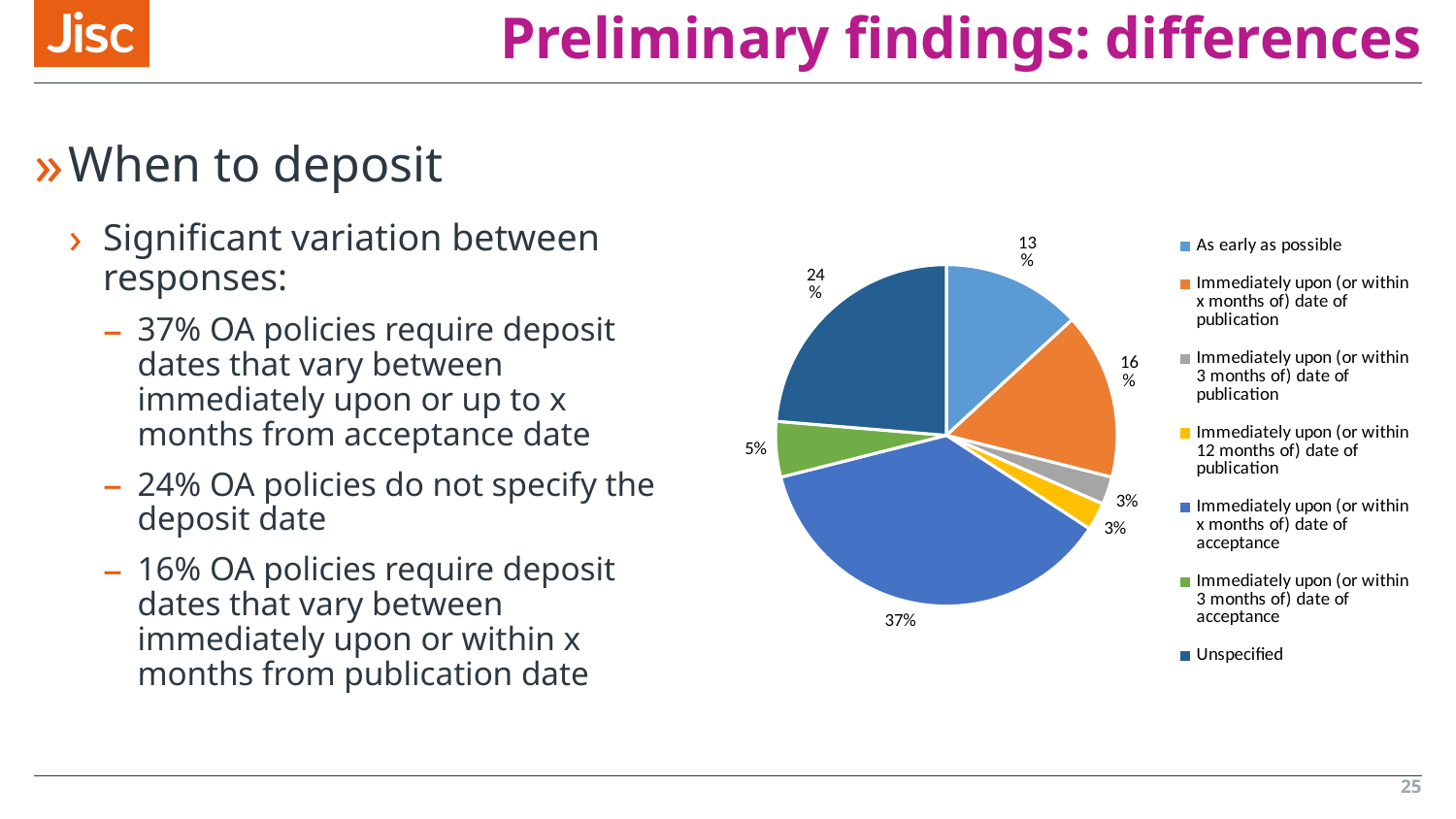
What percentage of the pie is labelled 'As early as possible'? 13% What is the difference in percentage points between the 'Immediately upon (or within x months of) date of acceptance' slice and the 'Unspecified' slice? 13 Which legend entry is shown in green? Immediately upon (or within 3 months of) date of acceptance What percentage of the pie is for 'Immediately upon (or within 3 months of) date of acceptance'? 5% Which category has the largest share of the pie? Immediately upon (or within x months of) date of acceptance Which is larger: the share for 'Unspecified' or the share for 'As early as possible'? Unspecified What percentage of the pie is labelled 'Unspecified'? 24% What percentage of the pie is for 'Immediately upon (or within x months of) date of acceptance'? 37% How many slices does the pie chart have? 7 How many entries does the legend of the pie chart list? 7 What is the difference in percentage points between 'Immediately upon (or within x months of) date of publication' and 'As early as possible'? 3 What type of chart is shown on the slide? Pie chart